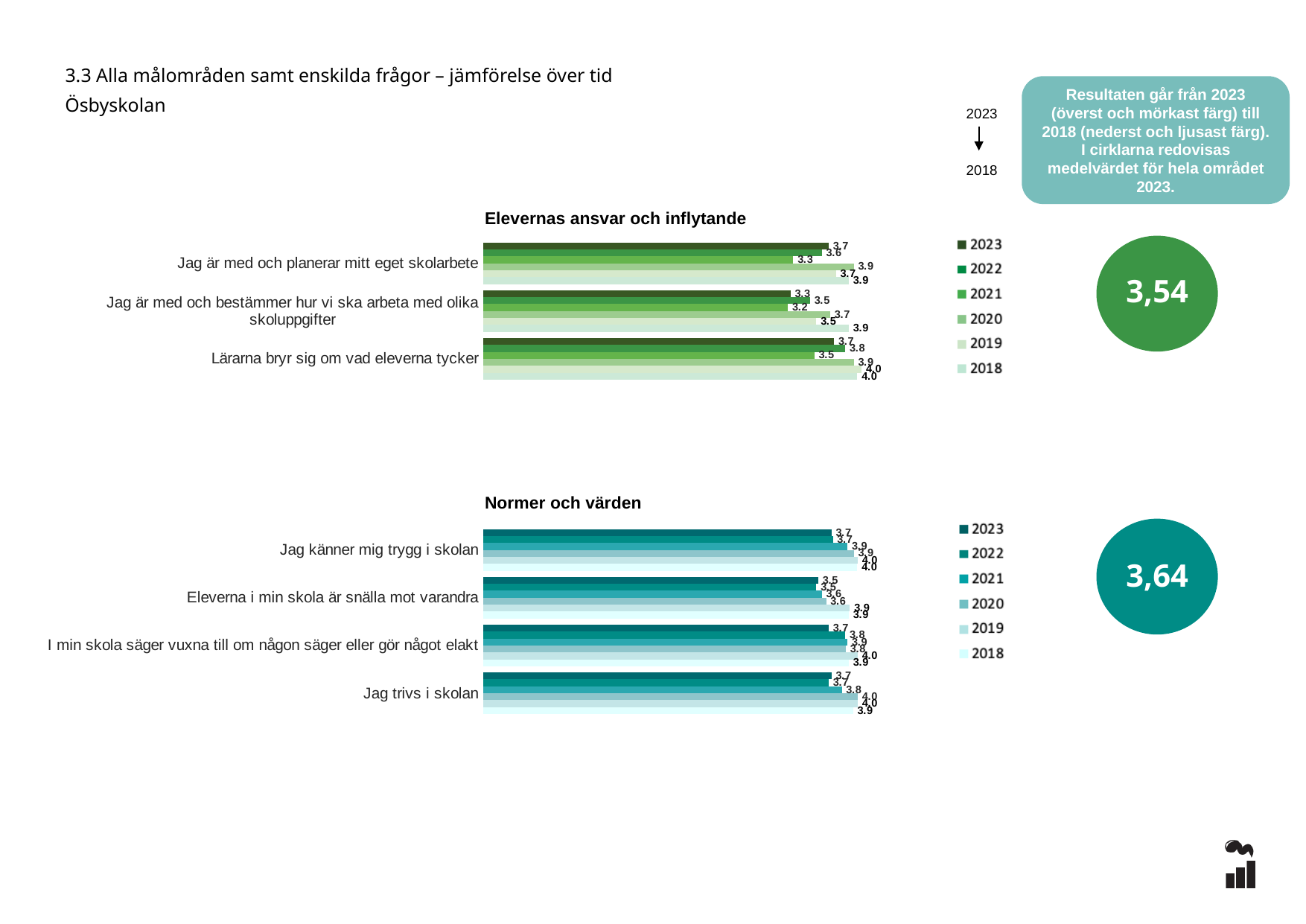
In the 'Elevernas ansvar och inflytande' chart, what is the 2021 value for 'Jag är med och bestämmer hur vi ska arbeta med olika skoluppgifter'? 3.2 How many categories (questions) are shown in the 'Elevernas ansvar och inflytande' chart? 3 What mean value for 2023 is shown in the circle next to the 'Normer och värden' chart? 3,64 What kind of chart is the 'Normer och värden' chart? Bar chart In the 'Elevernas ansvar och inflytande' chart, which has the higher 2023 value: 'Jag är med och planerar mitt eget skolarbete' or 'Jag är med och bestämmer hur vi ska arbeta med olika skoluppgifter'? Jag är med och planerar mitt eget skolarbete How many categories (questions) are shown in the 'Normer och värden' chart? 4 How many series does the legend of the 'Elevernas ansvar och inflytande' chart list? 6 In the 'Elevernas ansvar och inflytande' chart, what is the difference between the 2018 and 2023 values for 'Jag är med och bestämmer hur vi ska arbeta med olika skoluppgifter'? 0.6 In the 'Normer och värden' chart, what is the 2018 value for 'Jag trivs i skolan'? 3.9 In the 'Normer och värden' chart, what is the 2023 value for 'Eleverna i min skola är snälla mot varandra'? 3.5 In the 'Elevernas ansvar och inflytande' chart, what is the 2018 value for 'Lärarna bryr sig om vad eleverna tycker'? 4.0 In the 'Elevernas ansvar och inflytande' chart, what is the 2023 value for 'Jag är med och planerar mitt eget skolarbete'? 3.7